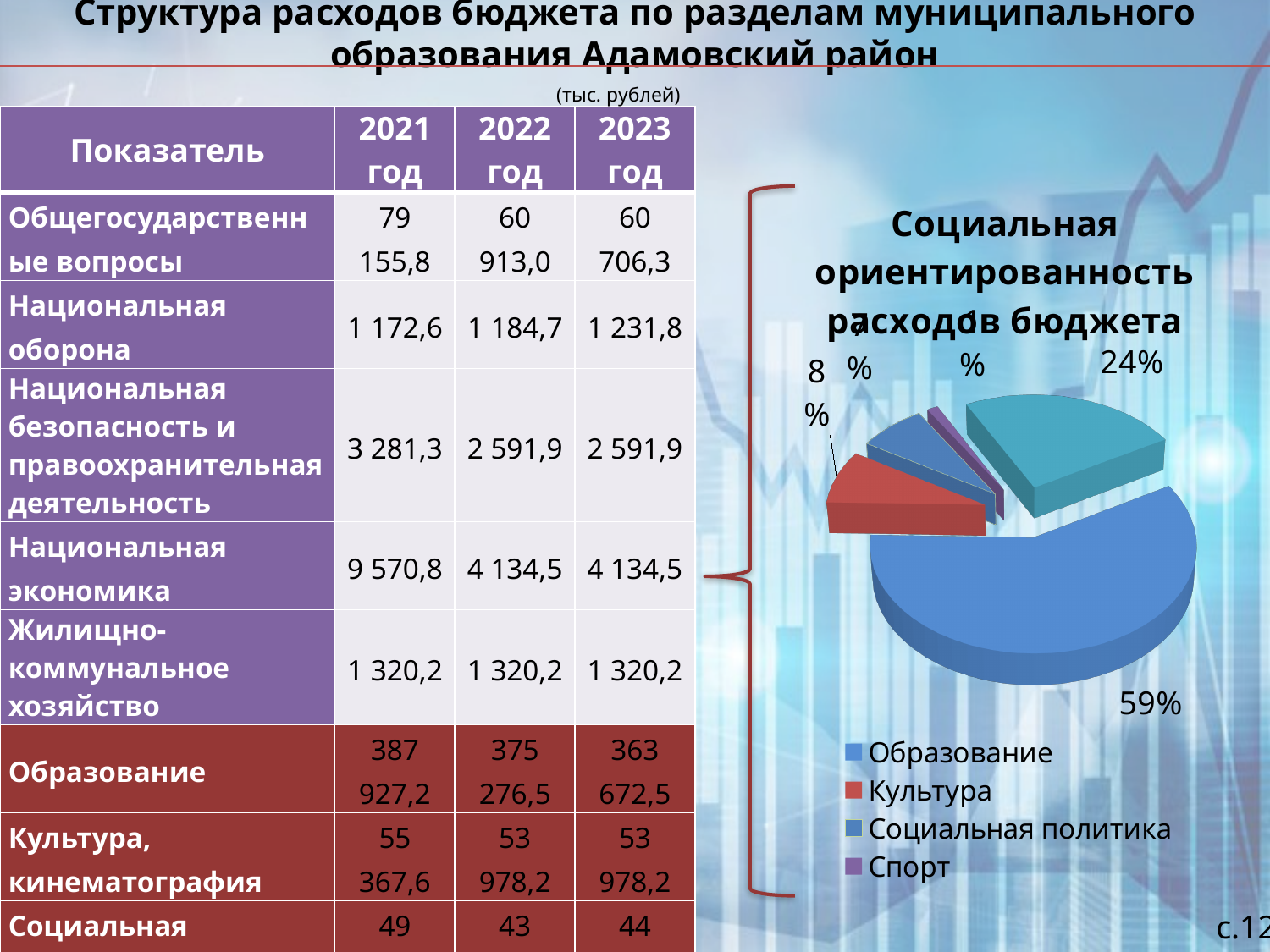
How many entries does the pie chart's legend list? 4 What share of the pie does Образование have? 59% What is the title of the pie chart? Социальная ориентированность расходов бюджета What share of the pie does Культура have? 8% Is the share for Образование greater or less than 50%? greater Which category has the largest slice of the pie chart? Образование What kind of chart is shown on the slide? pie chart What colour is the Образование slice in the pie chart? blue Which is larger in the pie chart, Культура or Социальная политика? Культура Which category has the smallest slice of the pie chart? Спорт